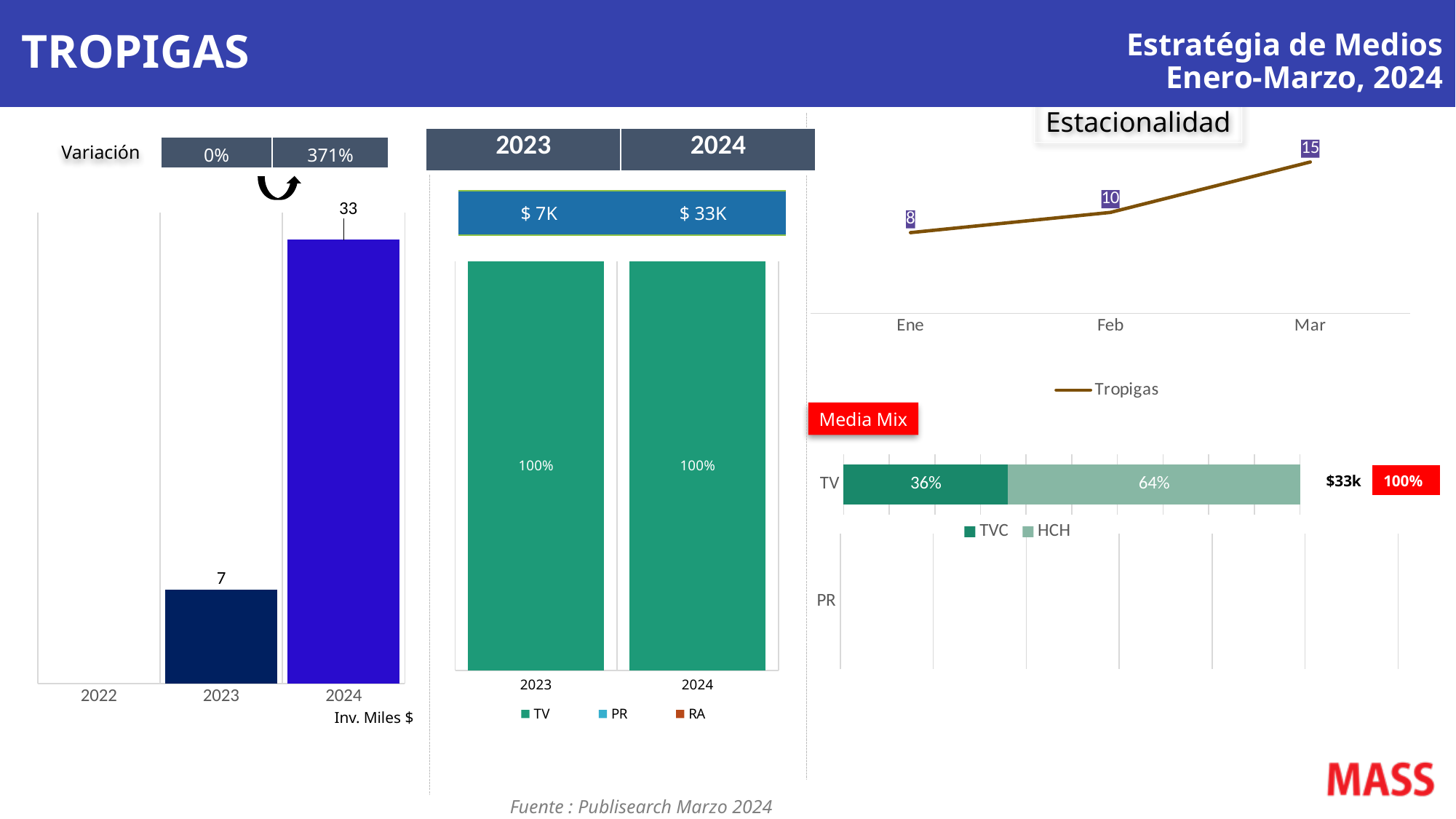
In the Media Mix chart, what share of TV does TVC account for? 36% In the left bar chart (Inv. Miles $), what is the value for 2023? 7 In the left bar chart (Inv. Miles $), what is the value for 2024? 33 In the Estacionalidad line chart, what is the value for Feb? 10 In the Estacionalidad line chart, do the values rise or fall from Ene to Mar? Rise In the Media Mix chart, which is larger for TV, TVC or HCH? HCH In the left bar chart (Inv. Miles $), what is the difference between the 2024 and 2023 values? 26 In the left bar chart (Inv. Miles $), which year has the highest value? 2024 In the Estacionalidad line chart, what is the value for Mar? 15 In the middle stacked bar chart (2023 vs 2024), how many series does the legend list? 3 In the Estacionalidad line chart, how many months are plotted? 3 What kind of chart is the left chart labelled Inv. Miles $? Bar chart